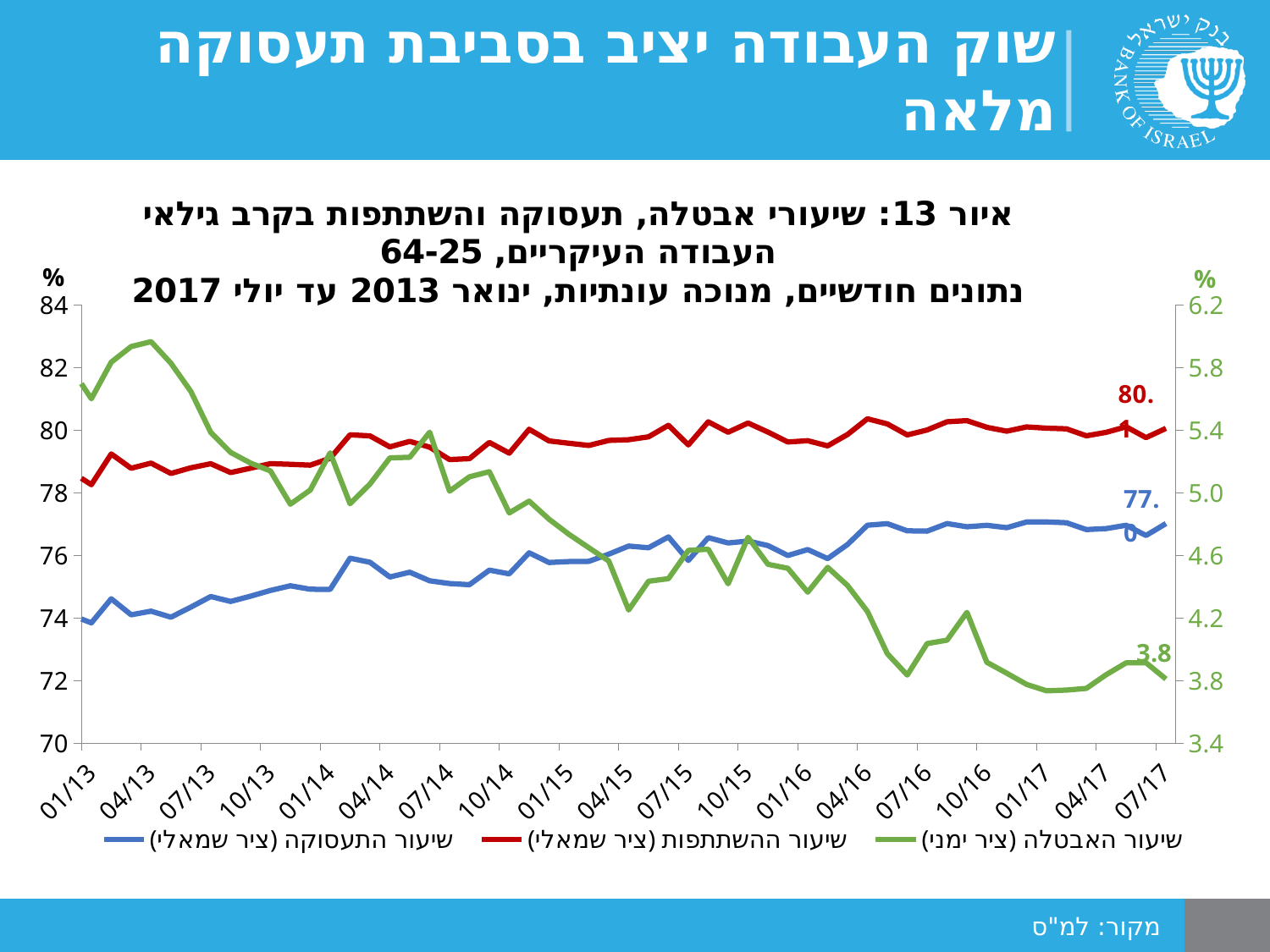
How many series does the legend list? 3 What is the highest tick value shown on the right axis? 6.2 What is the value of the unemployment rate (שיעור האבטלה) at the end of the series, in 07/17? 3.8 Does the unemployment rate (שיעור האבטלה, green line) rise or fall overall from 01/13 to 07/17? fall Is the employment rate (שיעור התעסוקה) in 01/13 greater or less than 76 on the left axis? less What kind of chart is shown on the slide? line chart What colour is the line for the participation rate (שיעור ההשתתפות)? red In 07/17, which is higher on the left axis: the participation rate (שיעור ההשתתפות) or the employment rate (שיעור התעסוקה)? שיעור ההשתתפות Is the participation rate (שיעור ההשתתפות) in 01/13 greater or less than 80 on the left axis? less Is the unemployment rate (שיעור האבטלה) in 04/13 greater or less than 5.4 on the right axis? greater Which series is plotted on the right axis (ציר ימני)? שיעור האבטלה Does the employment rate (שיעור התעסוקה, blue line) rise or fall overall from 01/13 to 07/17? rise